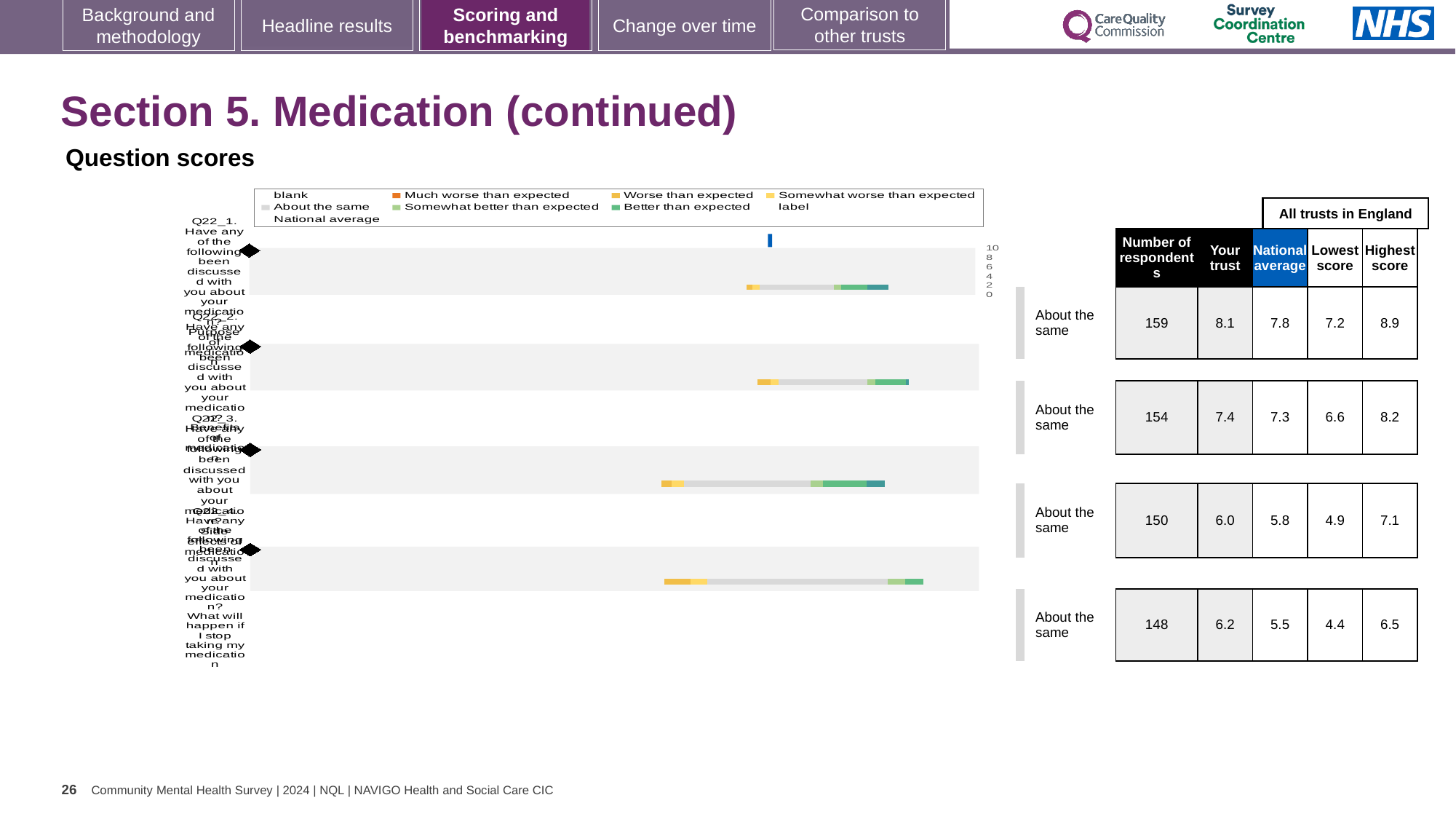
What kind of chart is shown on the slide? bar chart In the fourth row of the table, which is larger: the 'Your trust' score or the national average? Your trust (6.2) In the table, what is the highest score for the third row (Q22_3)? 7.1 How many question bars are plotted in the chart? 4 Which row in the table has the lowest 'Your trust' score? the third row (Q22_3), 6.0 Which legend entry is shown in orange? Much worse than expected In the table, what is the national average for the second row (Q22_2)? 7.3 In the first row of the table, what is the difference between the 'Your trust' score and the national average? 0.3 In the table, what is the lowest score for the fourth row (Q22_4)? 4.4 In the table, what is the 'Your trust' score for the first row (Q22_1)? 8.1 In the table, what is the number of respondents for the first row (Q22_1)? 159 Which row in the table has the highest 'Your trust' score? the first row (Q22_1), 8.1